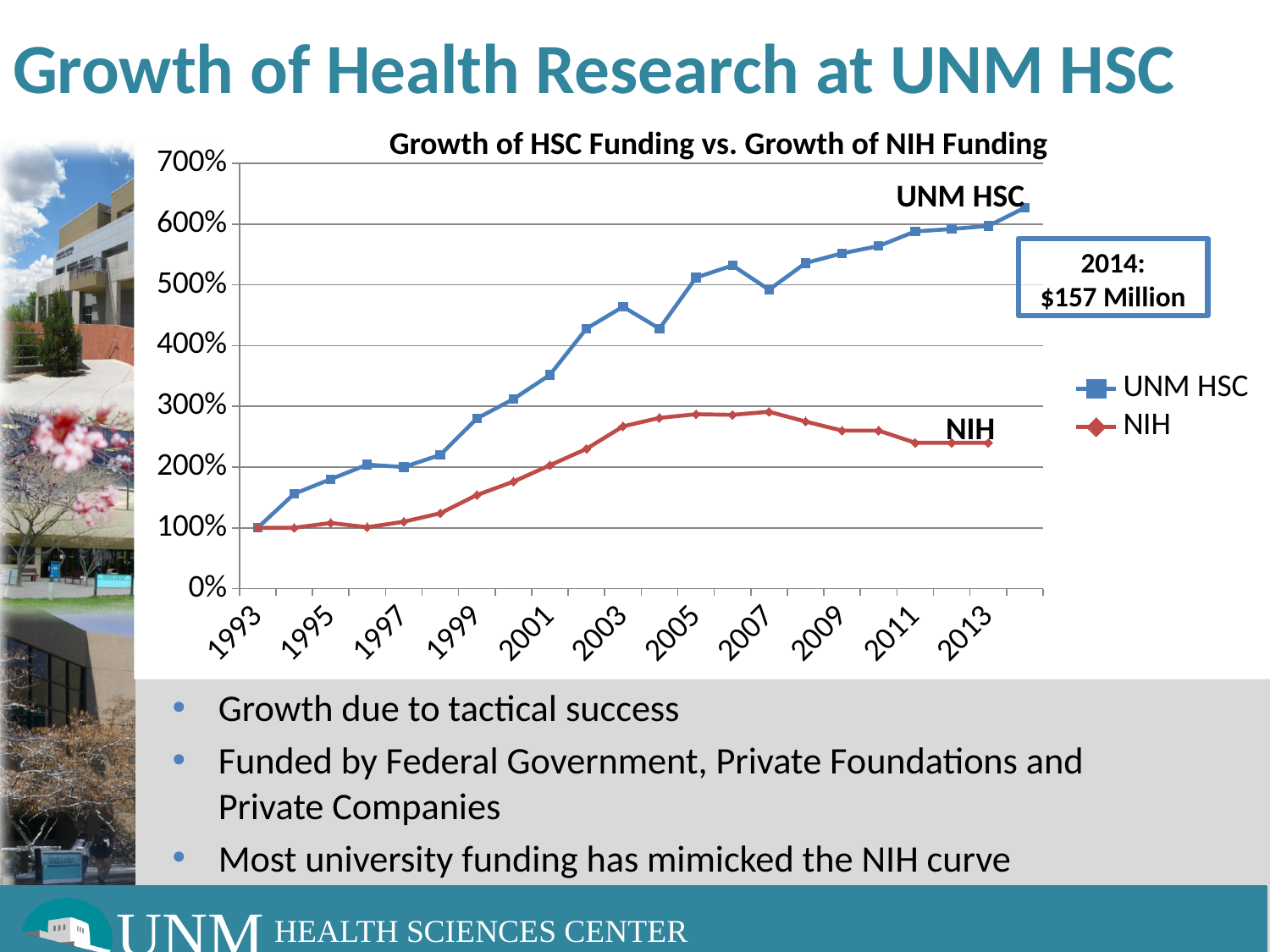
Does the NIH series rise or fall between 2007 and 2013? fall What is the value of the NIH series in 1993? 100% What kind of chart is shown on the slide? line chart What is the value of the UNM HSC series in 1993? 100% Is the value for NIH in 2013 greater or less than 300%? less In 2013, which series has the higher value, UNM HSC or NIH? UNM HSC Which two series are listed in the chart legend? UNM HSC and NIH Is the value for UNM HSC in 2013 greater or less than 500%? greater Is the value for UNM HSC in 2003 greater or less than 400%? greater How many series does the chart legend list? 2 What dollar amount does the annotation give for UNM HSC in 2014? $157 Million What is the title of the chart? Growth of HSC Funding vs. Growth of NIH Funding